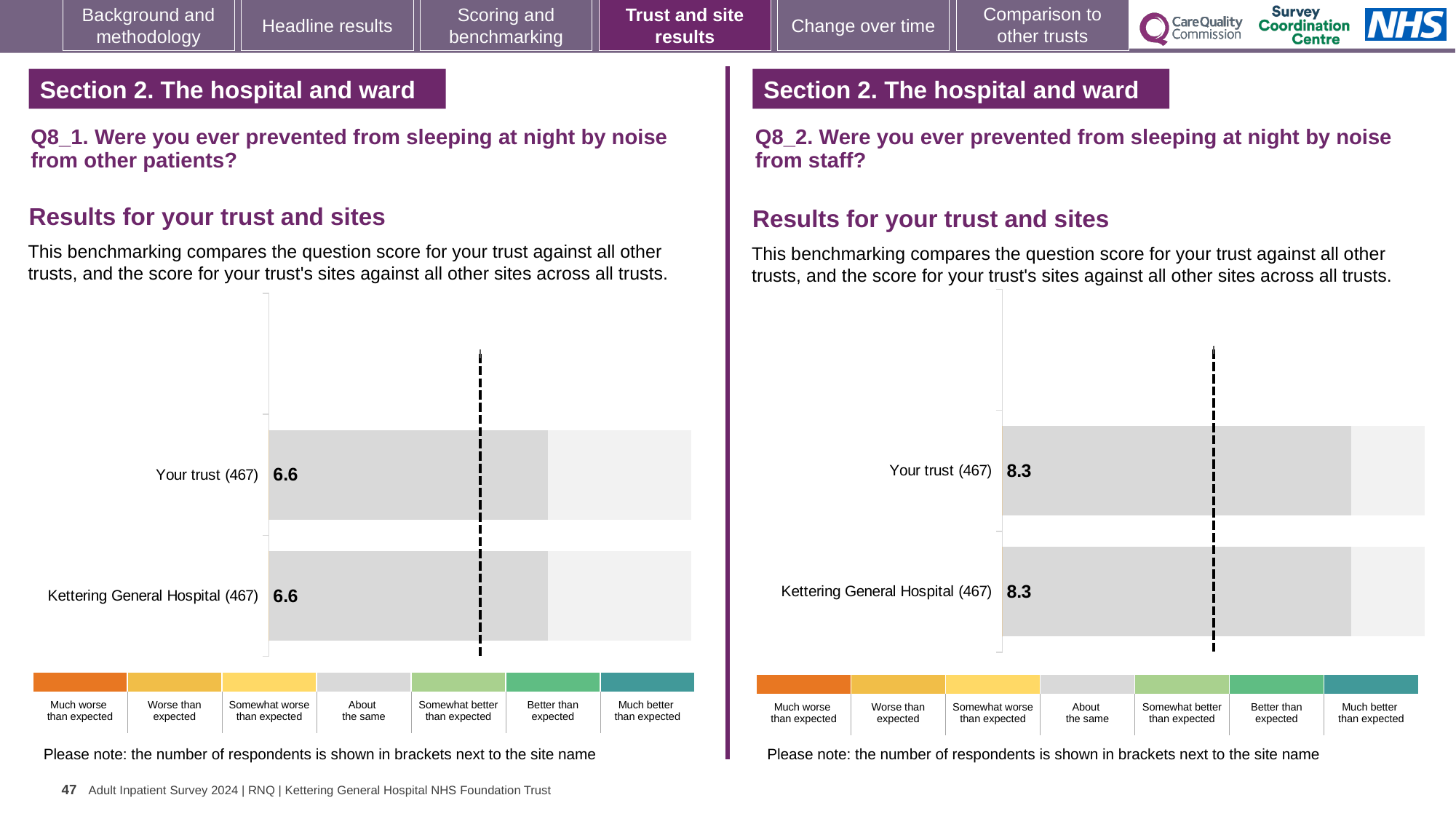
In the Q8_2 chart (right), what is the difference between the score for Your trust and the score for Kettering General Hospital? 0.0 Which question does the chart on the right of the slide relate to? Q8_2. Were you ever prevented from sleeping at night by noise from staff? In the Q8_1 chart (left), what is the score for Your trust? 6.6 In the Q8_1 chart (left), what is the score for Kettering General Hospital? 6.6 How many bars are plotted in the Q8_2 chart (right)? 2 In the Q8_1 chart (left), how many respondents are shown in brackets for Your trust? 467 In the Q8_2 chart (right), what is the score for Your trust? 8.3 What kind of chart is the Q8_2 chart (right)? Bar chart In the Q8_2 chart (right), what is the score for Kettering General Hospital? 8.3 How many categories does the colour key below the Q8_1 chart (left) list? 7 How many bars are plotted in the Q8_1 chart (left)? 2 In the Q8_1 chart (left), what is the difference between the score for Your trust and the score for Kettering General Hospital? 0.0